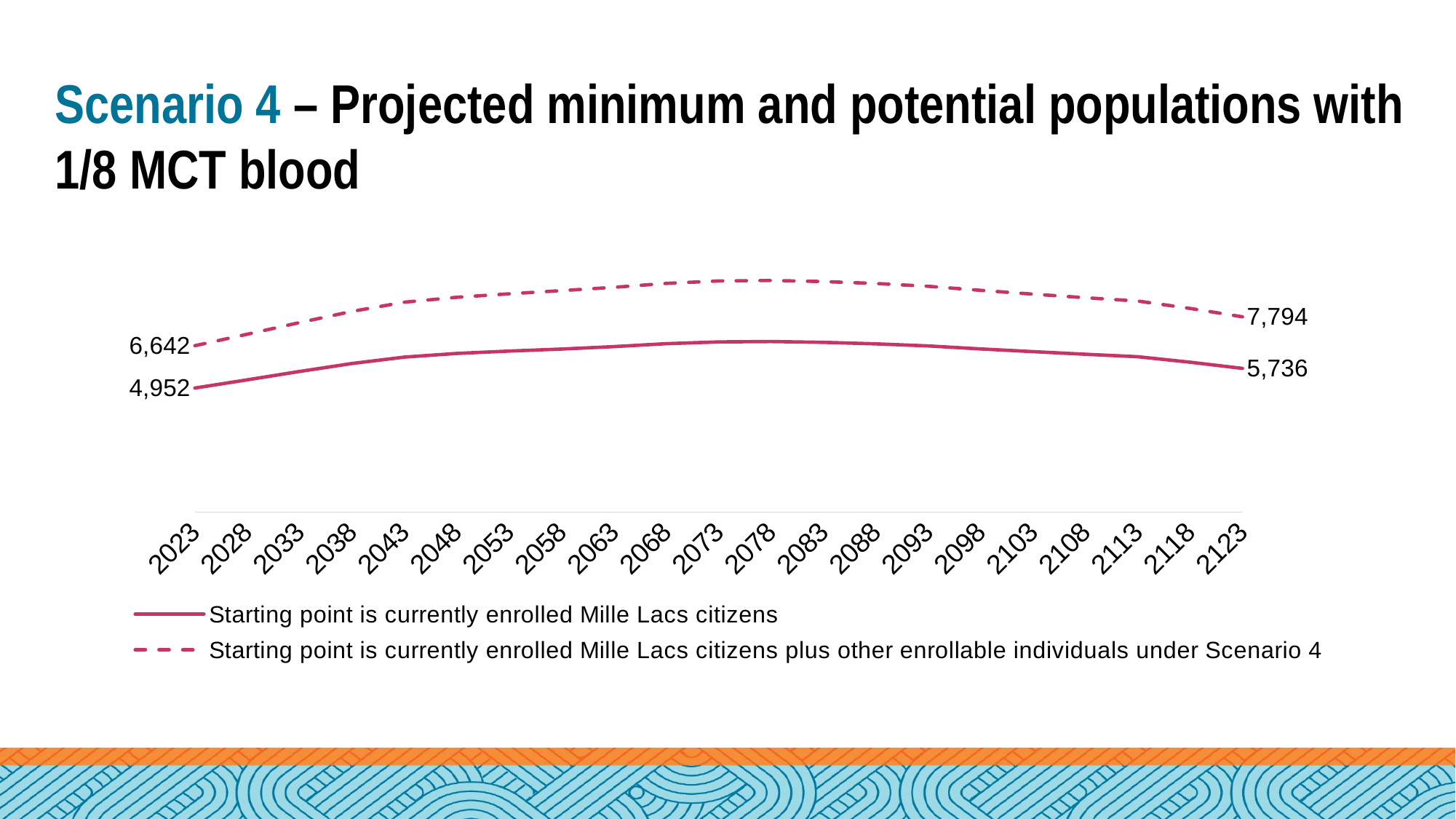
What is the 2123 value for the series 'Starting point is currently enrolled Mille Lacs citizens plus other enrollable individuals under Scenario 4'? 7,794 How many years are labelled on the x axis? 21 What is the difference between the two series' values in 2123? 2,058 Which series has the higher value in 2023? Starting point is currently enrolled Mille Lacs citizens plus other enrollable individuals under Scenario 4 What is the first year shown on the x axis? 2023 What is the difference between the 2123 and 2023 values for the series 'Starting point is currently enrolled Mille Lacs citizens'? 784 What type of chart is shown on the slide? Line chart What is the 2123 value for the series 'Starting point is currently enrolled Mille Lacs citizens'? 5,736 Which series is drawn with a dashed line? Starting point is currently enrolled Mille Lacs citizens plus other enrollable individuals under Scenario 4 What is the 2023 value for the series 'Starting point is currently enrolled Mille Lacs citizens plus other enrollable individuals under Scenario 4'? 6,642 What is the 2023 value for the series 'Starting point is currently enrolled Mille Lacs citizens'? 4,952 How many series does the legend list? 2